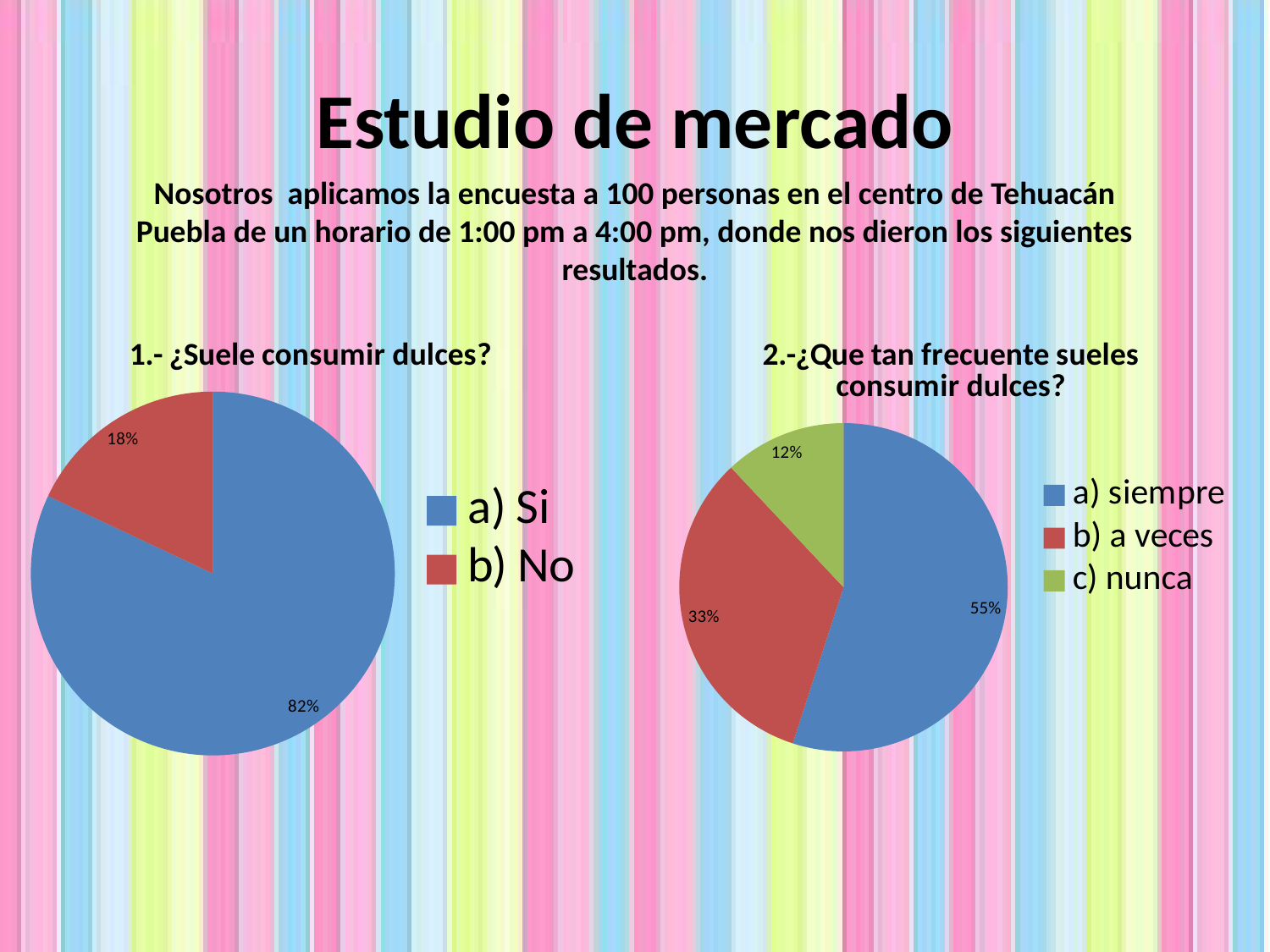
How many slices does the right pie chart '2.-¿Que tan frecuente sueles consumir dulces?' have? 3 In the right pie chart '2.-¿Que tan frecuente sueles consumir dulces?', what is the difference in percentage points between 'a) siempre' and 'b) a veces'? 22 How many entries does the legend of the left pie chart '1.- ¿Suele consumir dulces?' list? 2 In the right pie chart '2.-¿Que tan frecuente sueles consumir dulces?', what percentage is shown for 'b) a veces'? 33% In the right pie chart '2.-¿Que tan frecuente sueles consumir dulces?', which category has the smallest share? c) nunca In the left pie chart '1.- ¿Suele consumir dulces?', what percentage is shown for 'b) No'? 18% In the right pie chart '2.-¿Que tan frecuente sueles consumir dulces?', what percentage is shown for 'c) nunca'? 12% In the left pie chart '1.- ¿Suele consumir dulces?', what is the difference in percentage points between 'a) Si' and 'b) No'? 64 In the right pie chart '2.-¿Que tan frecuente sueles consumir dulces?', which category has the largest share? a) siempre In the right pie chart '2.-¿Que tan frecuente sueles consumir dulces?', which is larger: 'b) a veces' or 'c) nunca'? b) a veces What type of chart is used for '1.- ¿Suele consumir dulces?'? Pie chart In the left pie chart '1.- ¿Suele consumir dulces?', what percentage is shown for 'a) Si'? 82%